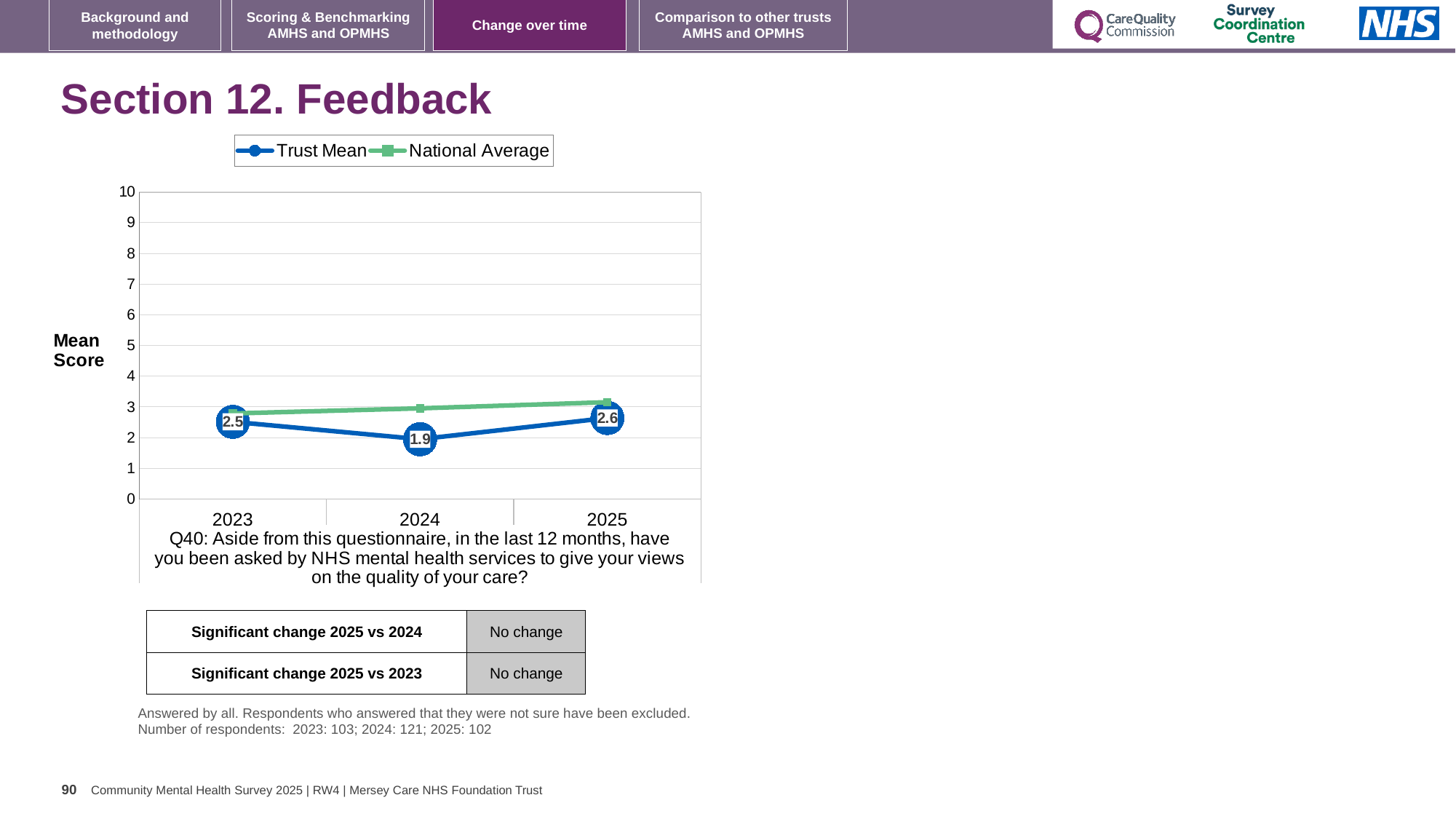
In 2024, which series has the higher value, Trust Mean or National Average? National Average What is the Trust Mean score for 2023? 2.5 What is the difference between the Trust Mean scores for 2025 and 2024? 0.7 In which year is the Trust Mean score lowest? 2024 Is the National Average value for 2025 greater or less than 5? less What is the Trust Mean score for 2024? 1.9 What is the Trust Mean score for 2025? 2.6 How many series does the legend list? 2 In which year is the Trust Mean score highest? 2025 Which year has the larger Trust Mean score, 2023 or 2025? 2025 How many years are plotted on the x axis? 3 What kind of chart is shown on the slide? line chart